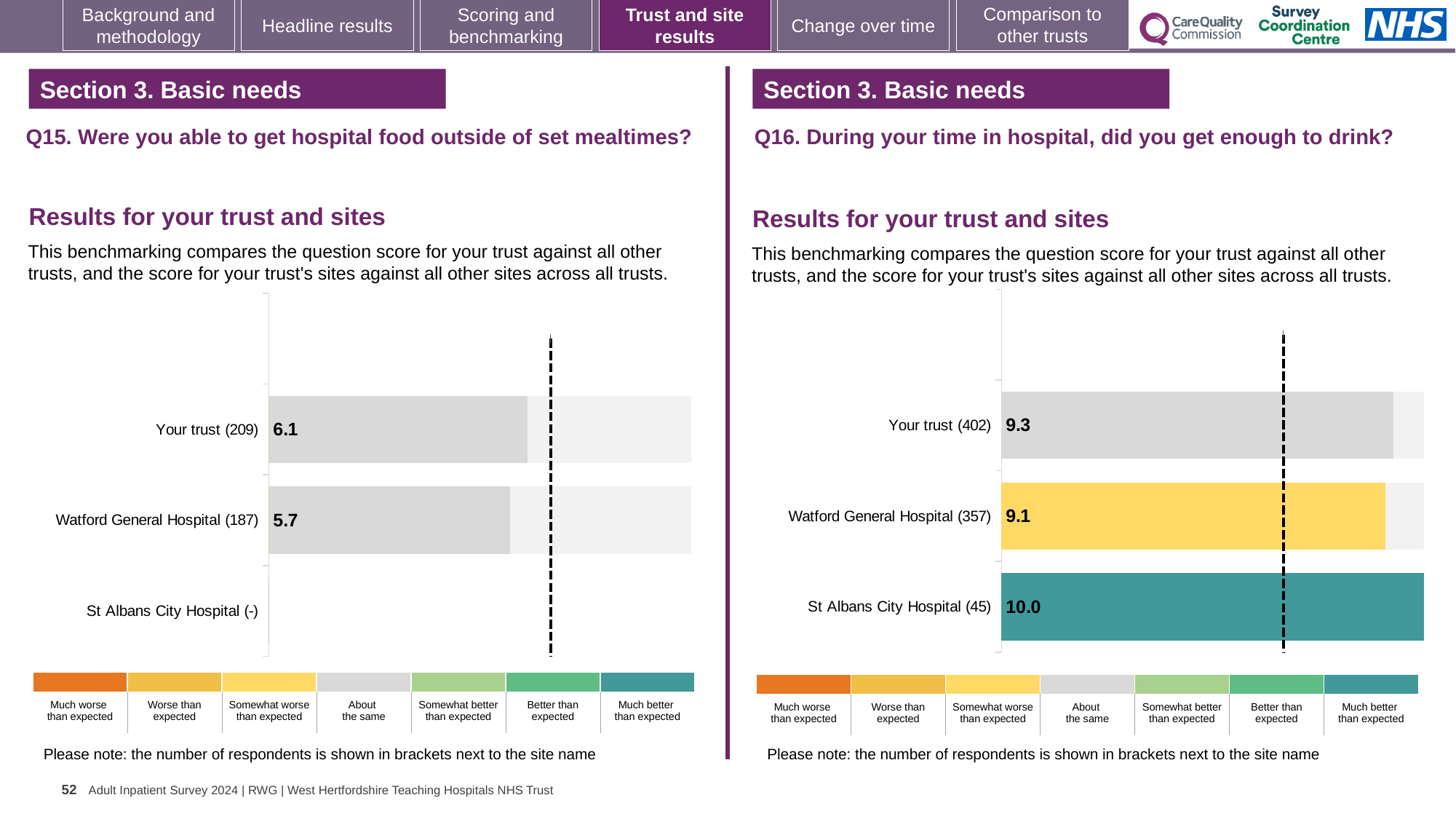
In the Q15 chart (hospital food outside of set mealtimes), what is the score for Your trust? 6.1 In the Q16 chart (did you get enough to drink), what is the score for St Albans City Hospital? 10.0 What kind of chart is used for the Q16 results (did you get enough to drink)? Bar chart In the Q15 chart (hospital food outside of set mealtimes), what is the difference between the scores for Your trust and Watford General Hospital? 0.4 In the Q16 chart (did you get enough to drink), what is the score for Watford General Hospital? 9.1 In the Q16 chart (did you get enough to drink), which benchmark category does the colour of the St Albans City Hospital bar correspond to? Much better than expected In the Q15 chart (hospital food outside of set mealtimes), how many respondents are shown in brackets for Your trust? 209 In the Q16 chart (did you get enough to drink), which site or trust has the highest score? St Albans City Hospital In the Q16 chart (did you get enough to drink), what is the difference between the scores for St Albans City Hospital and Your trust? 0.7 In the Q16 chart (did you get enough to drink), which site or trust has the lowest score? Watford General Hospital In the Q15 chart (hospital food outside of set mealtimes), what is the score for Watford General Hospital? 5.7 In the Q16 chart (did you get enough to drink), which has the larger score, Your trust or Watford General Hospital? Your trust